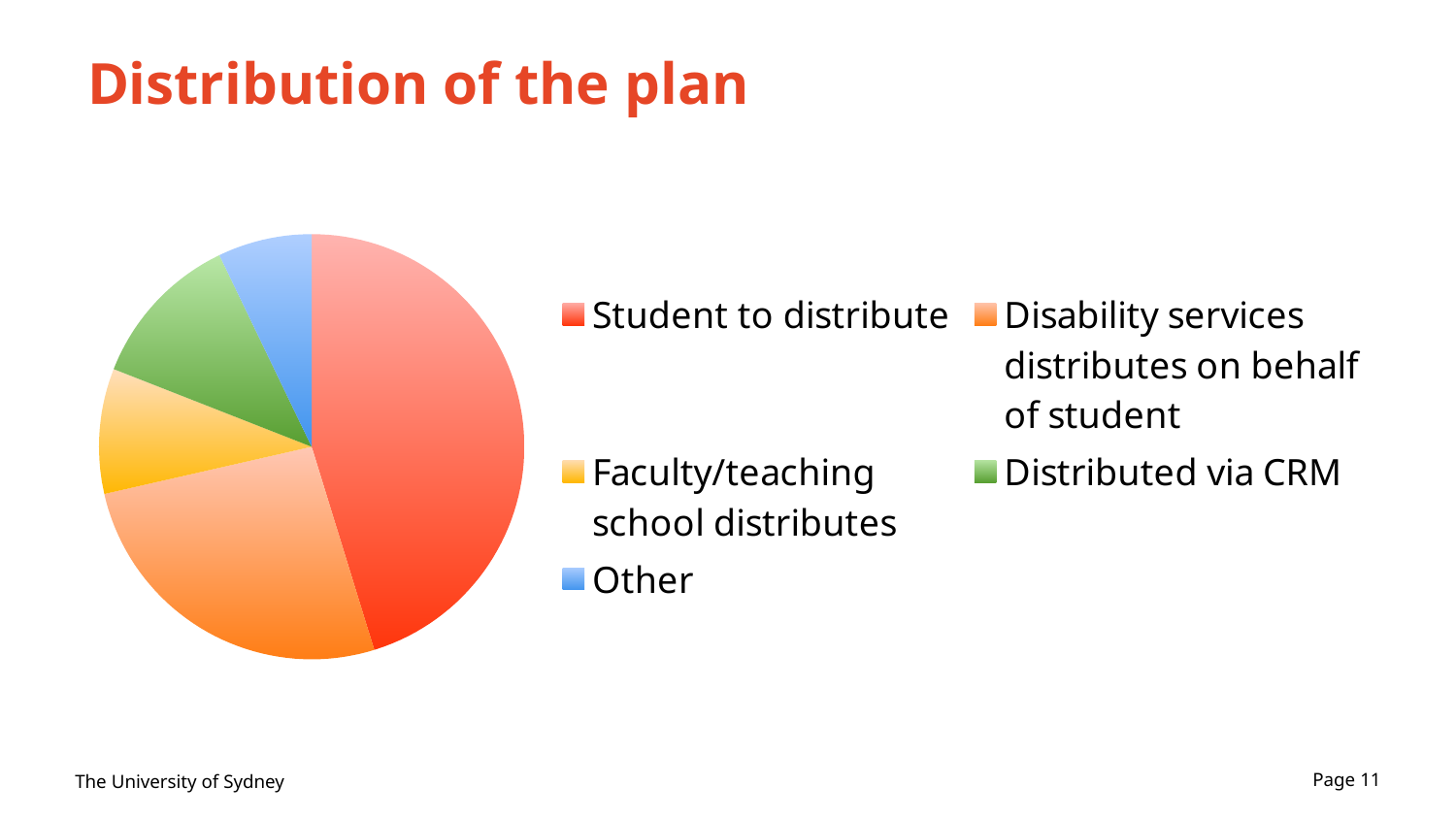
What colour is the slice for Distributed via CRM in the pie chart? green Which category has the largest slice of the pie chart? Student to distribute Which slice is larger: Disability services distributes on behalf of student or Distributed via CRM? Disability services distributes on behalf of student Which slice is larger: Student to distribute or Disability services distributes on behalf of student? Student to distribute How many entries does the legend of the pie chart list? 5 What is the title of the slide containing the pie chart? Distribution of the plan Which slice is larger: Other or Disability services distributes on behalf of student? Disability services distributes on behalf of student What kind of chart is shown on the slide? pie chart How many slices does the pie chart have? 5